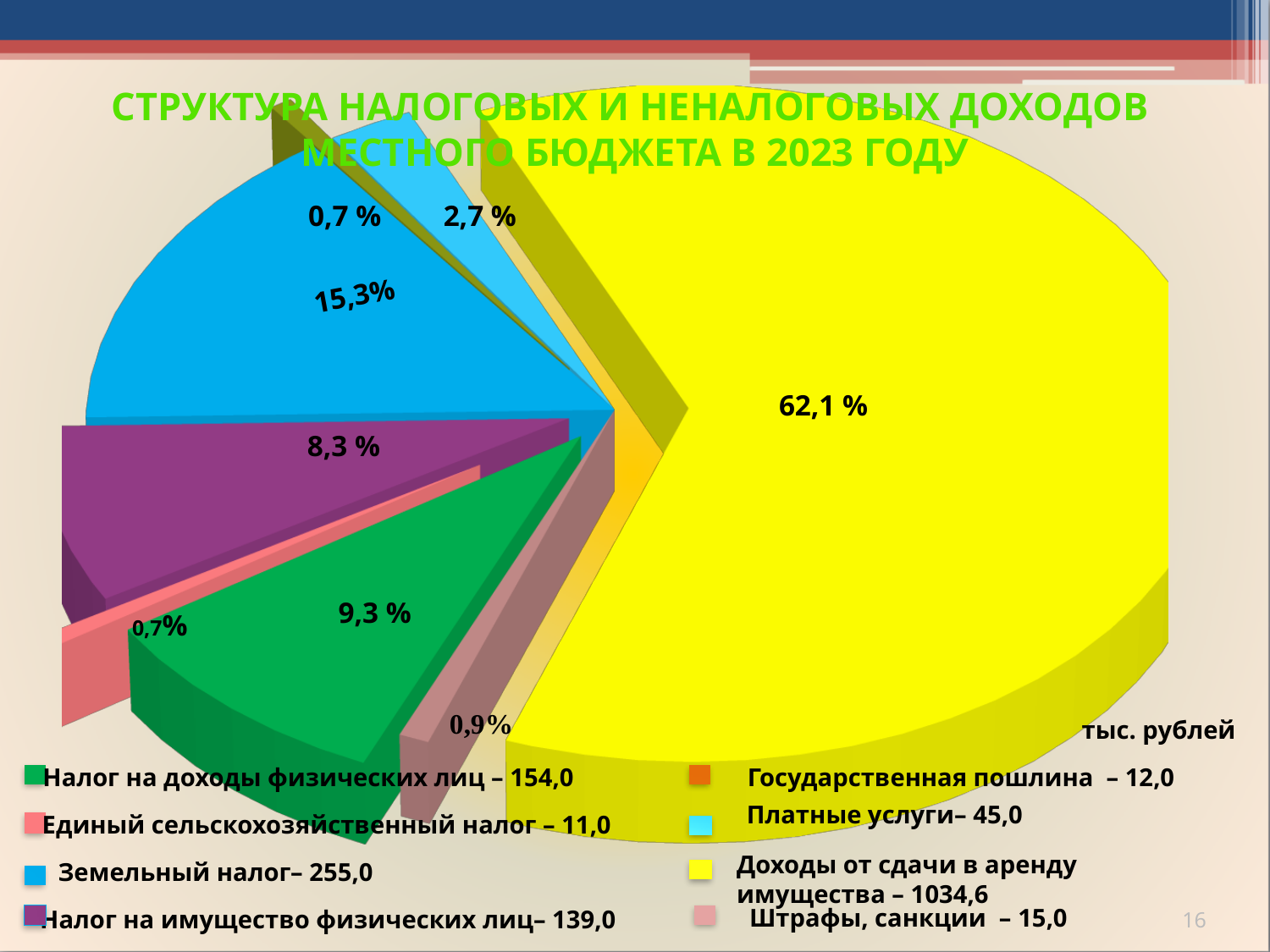
What share of the pie does Земельный налог take? 15,3% Which category has the smallest value in the legend? Единый сельскохозяйственный налог What share of the pie does Доходы от сдачи в аренду имущества take? 62,1 % Which is larger: the value for Земельный налог or the value for Налог на имущество физических лиц? Земельный налог What is the value shown in the legend for Налог на доходы физических лиц? 154,0 What is the value shown in the legend for Земельный налог? 255,0 Which category has the largest share of the pie? Доходы от сдачи в аренду имущества How many categories does the legend of the pie chart list? 8 In what units are the legend values given, according to the slide? тыс. рублей What is the value shown in the legend for Платные услуги? 45,0 What is the difference between the legend values for Земельный налог and Налог на доходы физических лиц? 101,0 What kind of chart is shown on the slide? pie chart